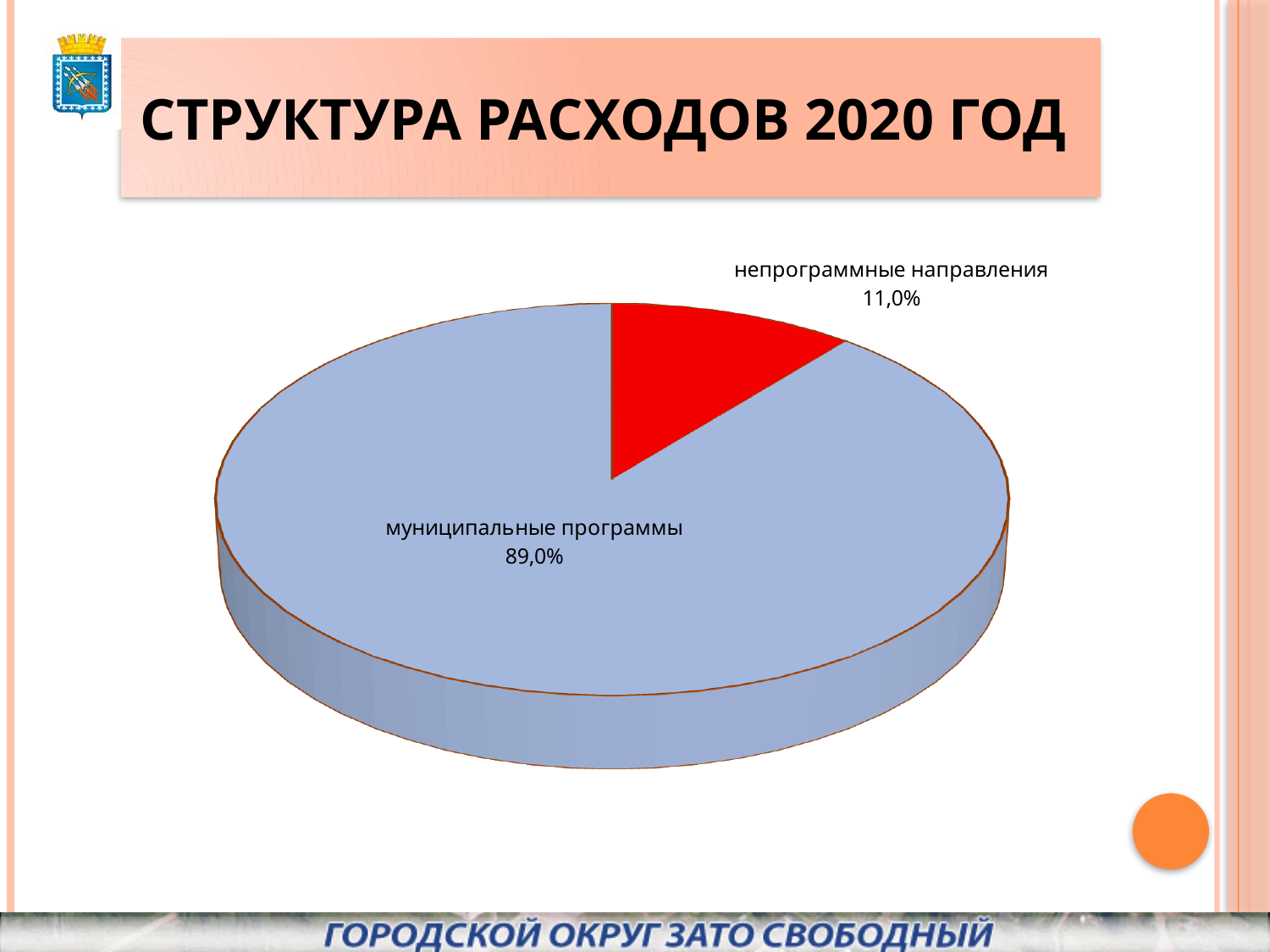
What share of expenditures is labelled for непрограммные направления? 11,0% Which is larger: the share for муниципальные программы or for непрограммные направления? муниципальные программы What is the combined share of the two slices shown? 100,0% How many slices does the pie chart have? 2 Which slice of the pie is the largest? муниципальные программы What share of expenditures is labelled for муниципальные программы? 89,0% What is the difference in percentage points between муниципальные программы and непрограммные направления? 78,0% Which slice of the pie is the smallest? непрограммные направления What kind of chart is shown on the slide? pie chart What colour is the slice for непрограммные направления? red What is the title of the slide containing the chart? СТРУКТУРА РАСХОДОВ 2020 ГОД